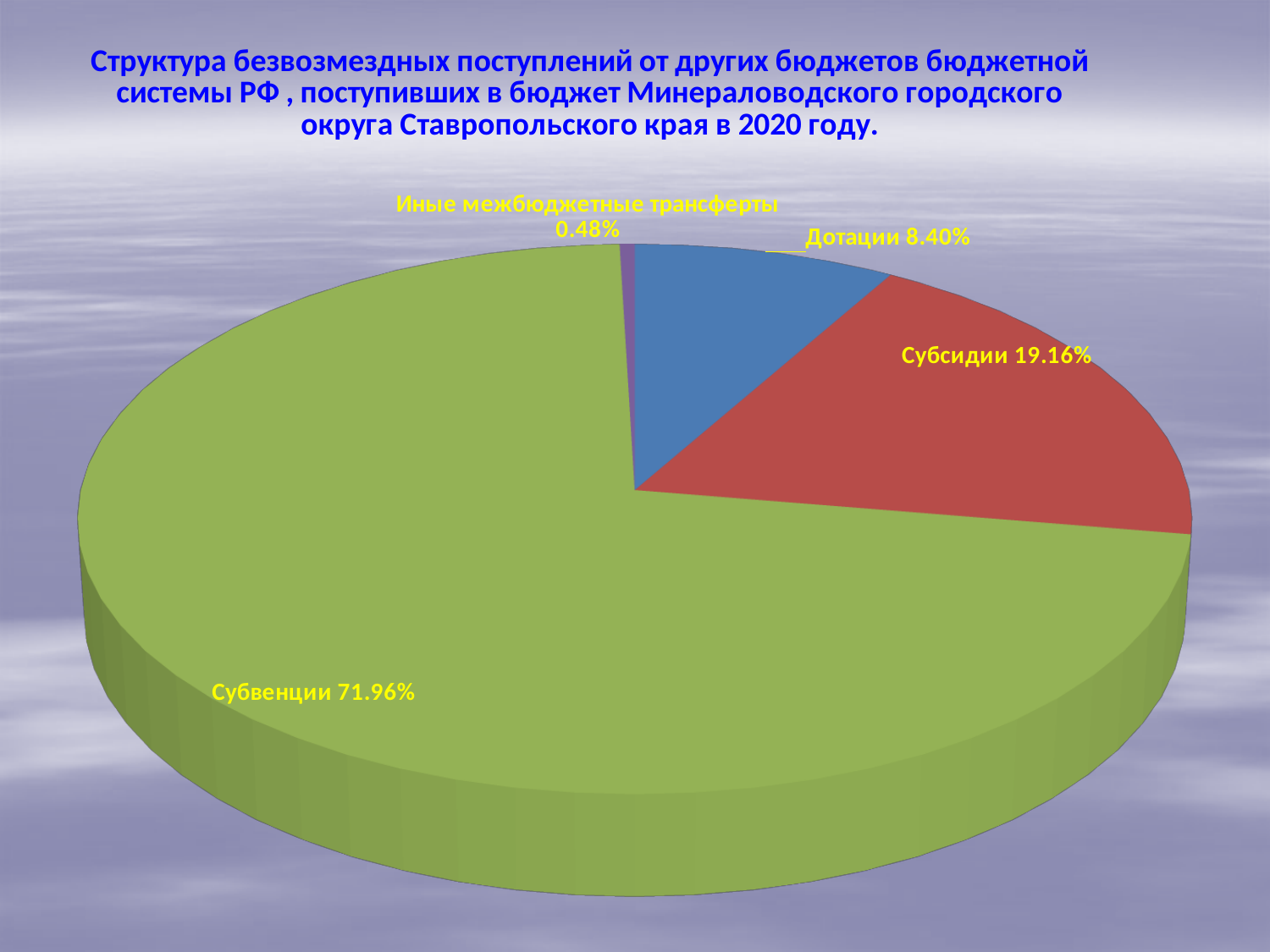
Which year does the chart title say the data refers to? 2020 What is the difference in percentage points between Субсидии and Дотации? 10.76 Which is larger, the slice for Дотации or the slice for Субсидии? Субсидии Which category has the smallest slice of the pie? Иные межбюджетные трансферты What is the value shown for Субсидии? 19.16% What is the value shown for Дотации? 8.40% What is the value shown for Иные межбюджетные трансферты? 0.48% Which category has the largest slice of the pie? Субвенции What colour is the slice for Субвенции? Green How many categories are shown in the pie chart? 4 What kind of chart is shown on the slide? Pie chart What share of the pie does Субвенции represent? 71.96%